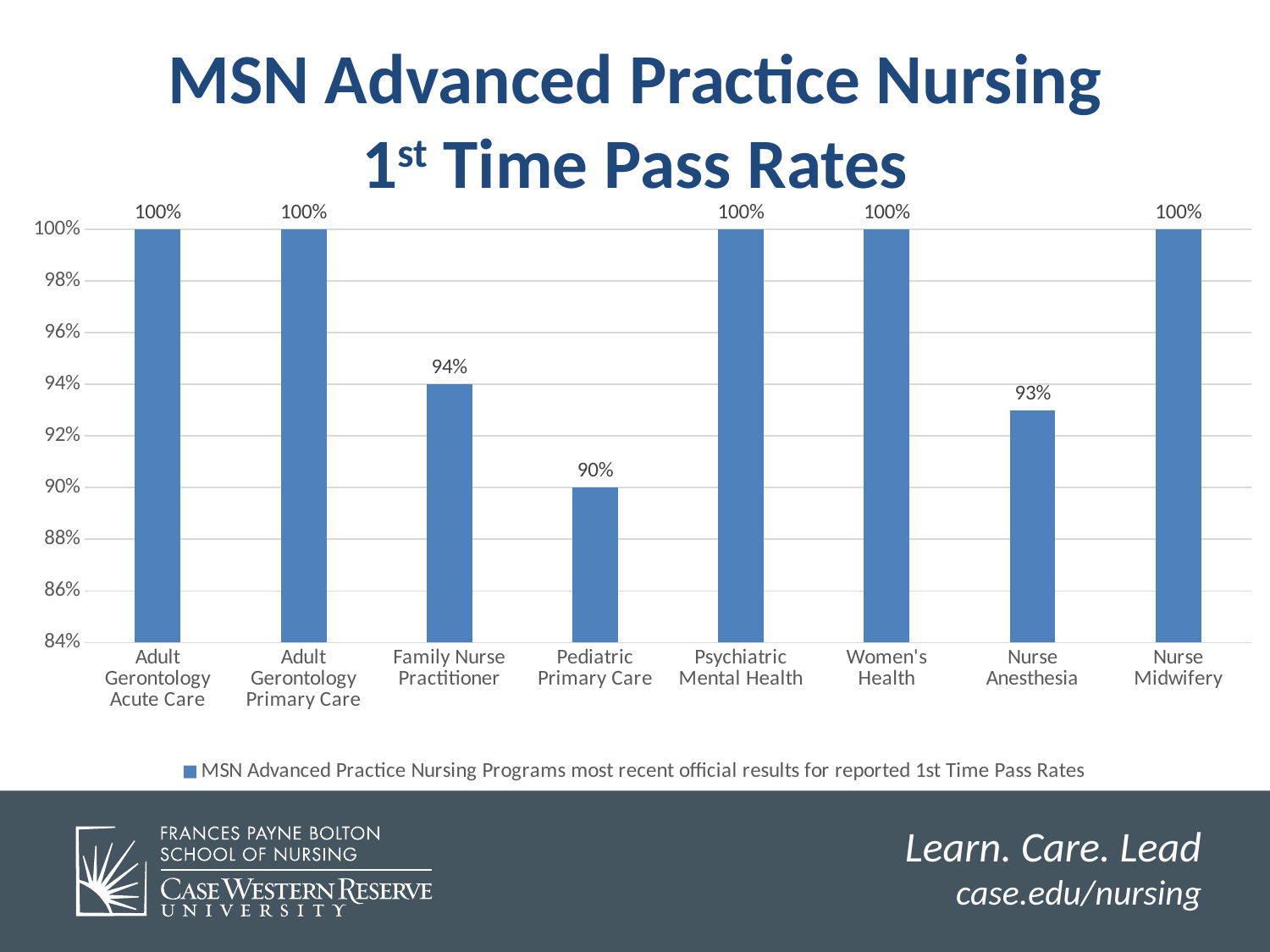
What is the difference between the pass rates for Family Nurse Practitioner and Pediatric Primary Care? 4% Which program has the lowest 1st time pass rate? Pediatric Primary Care What is the 1st time pass rate for Pediatric Primary Care? 90% What kind of chart is shown on the slide? Bar chart What is the title of the chart? MSN Advanced Practice Nursing 1st Time Pass Rates What is the 1st time pass rate for Family Nurse Practitioner? 94% How many programs are shown on the chart? 8 How many programs have a 1st time pass rate of 100%? 5 What is the difference between the pass rates for Women's Health and Nurse Anesthesia? 7% What is the 1st time pass rate for Nurse Midwifery? 100% What is the 1st time pass rate for Nurse Anesthesia? 93% Which has a higher pass rate, Family Nurse Practitioner or Nurse Anesthesia? Family Nurse Practitioner